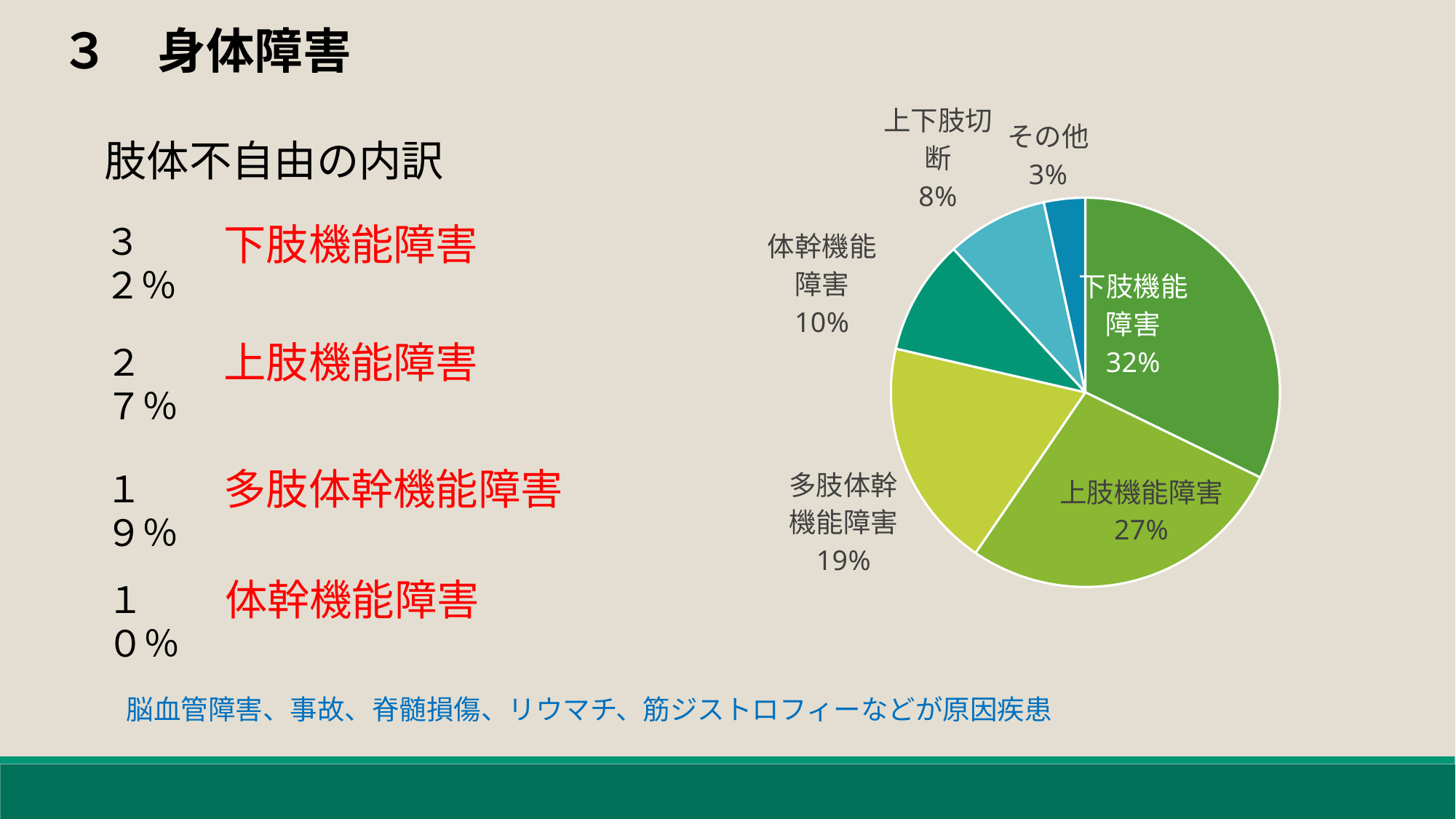
What share of the pie does 多肢体幹機能障害 have? 19% What share of the pie does 体幹機能障害 have? 10% Which category has the largest slice of the pie? 下肢機能障害 What share of the pie does 上下肢切断 have? 8% Which category has the smallest slice of the pie? その他 How many slices does the pie chart have? 6 What kind of chart is shown on the slide? pie chart What is the difference in percentage points between 下肢機能障害 and 上肢機能障害? 5 Which is larger, the share for 体幹機能障害 or the share for 上下肢切断? 体幹機能障害